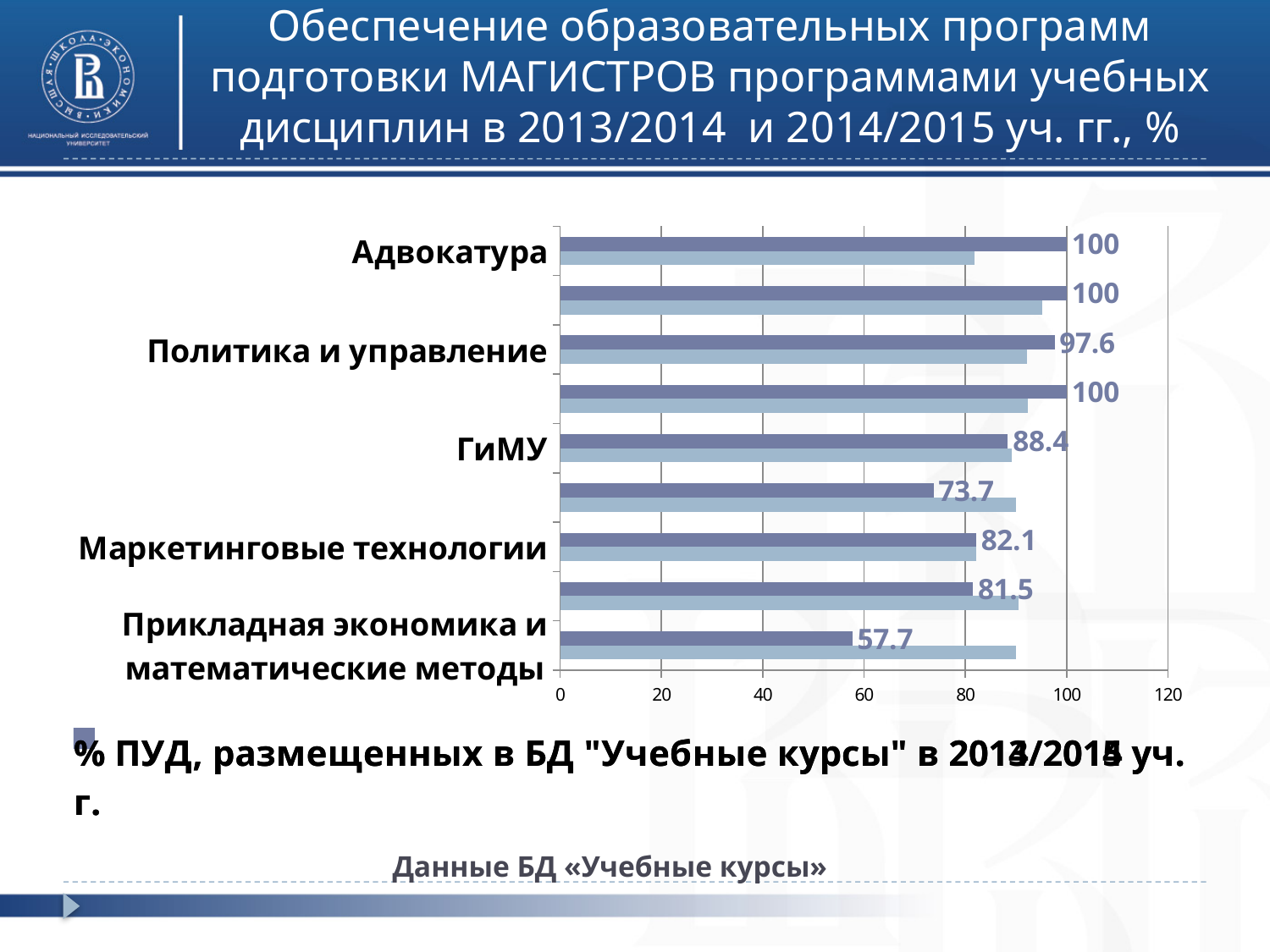
Is the light blue bar for Прикладная экономика и математические методы greater or less than 80? greater How many dark blue bars are labelled with the value 100? 3 Which has a larger dark blue bar value: Политика и управление or ГиМУ? Политика и управление What is the highest tick value shown on the horizontal axis? 120 What is the value of the dark blue bar for Адвокатура? 100 Which labelled category has the lowest dark blue bar value? Прикладная экономика и математические методы What is the value of the dark blue bar for Политика и управление? 97.6 What type of chart is shown on the slide? bar chart What is the value of the dark blue bar for ГиМУ? 88.4 What is the value of the dark blue bar for Маркетинговые технологии? 82.1 What is the value of the dark blue bar for Прикладная экономика и математические методы? 57.7 What is the difference between the dark blue bar values for ГиМУ and Прикладная экономика и математические методы? 30.7